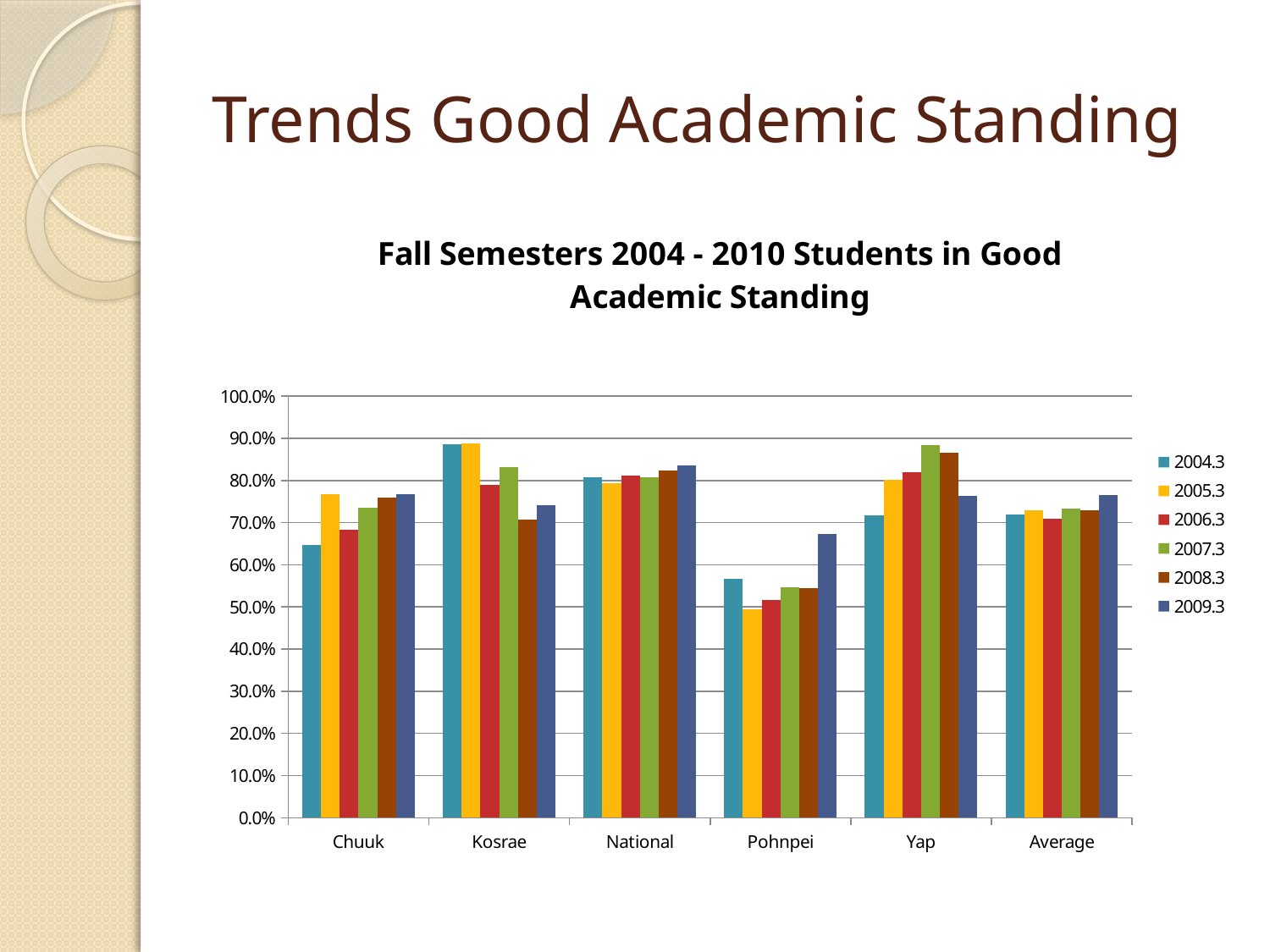
Is the value for Pohnpei in 2009.3 greater or less than 60.0%? greater Is the value for Pohnpei in 2004.3 greater or less than 50.0%? greater Is the value for Chuuk in 2004.3 greater or less than 70.0%? less Which category has the lowest value for the 2005.3 series? Pohnpei For Kosrae, which is larger: the 2004.3 value or the 2008.3 value? 2004.3 What kind of chart is shown on the slide? Bar chart For Pohnpei, which is larger: the 2004.3 value or the 2009.3 value? 2009.3 What is the title of the chart? Fall Semesters 2004 - 2010 Students in Good Academic Standing Which category has the highest value for the 2007.3 series? Yap How many series does the legend list? 6 How many categories are shown on the x axis? 6